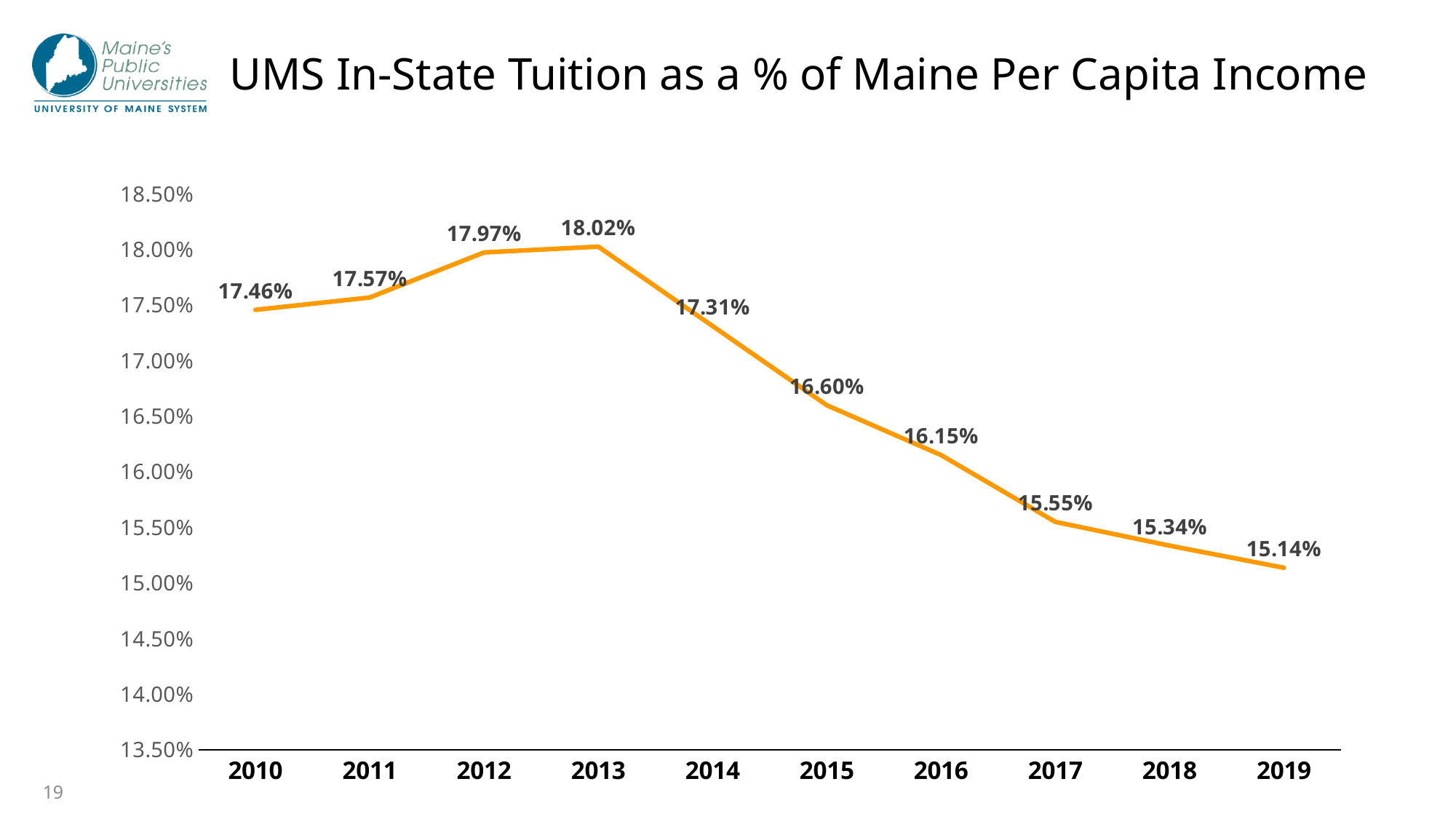
Do the values rise or fall from 2013 to 2019? Fall Which year has a larger value, 2012 or 2015? 2012 What is the difference between the 2013 value and the 2019 value? 2.88% What value is shown for 2010? 17.46% What value is shown for 2019? 15.14% Which year has the lowest value? 2019 What was UMS in-state tuition as a % of Maine per capita income in 2013? 18.02% Is the value for 2016 greater or less than 16.00%? greater What is the title of the chart? UMS In-State Tuition as a % of Maine Per Capita Income How many years are plotted on the x axis? 10 What kind of chart is shown? Line chart Which year has the highest value? 2013